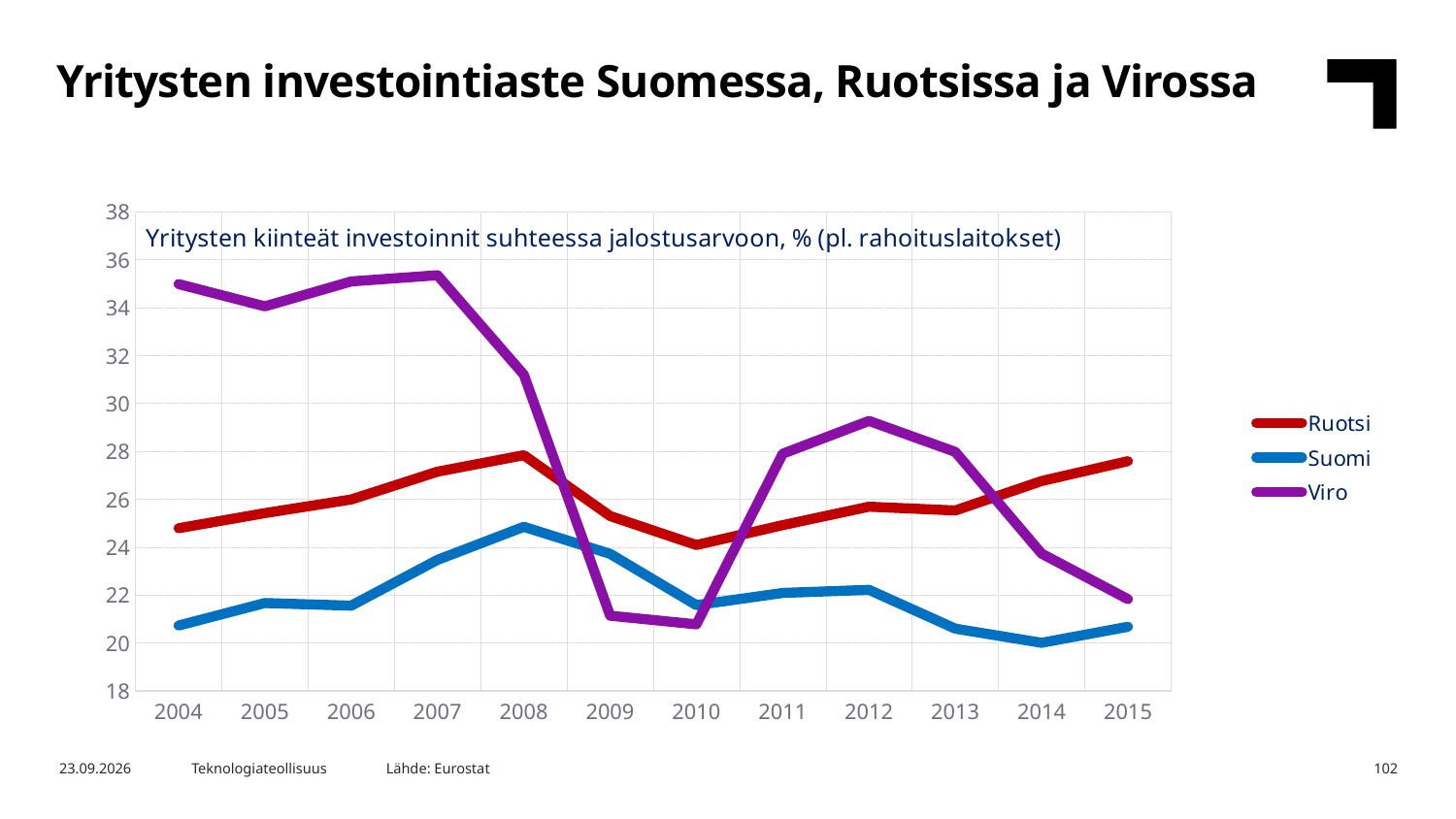
Is the value for Viro in 2009 greater or less than 24? less In 2010, which series has the larger value, Ruotsi or Viro? Ruotsi How many series does the legend list? 3 What kind of chart is shown on the slide? line chart Which series has the lowest value in 2015? Suomi Does the value for Viro rise or fall from 2012 to 2015? fall Is the value for Ruotsi in 2008 greater or less than 26? greater How many years are shown on the x axis? 12 Is the value for Viro in 2004 greater or less than 30? greater Which series has the highest value in 2012? Viro In which year does Suomi reach its highest value? 2008